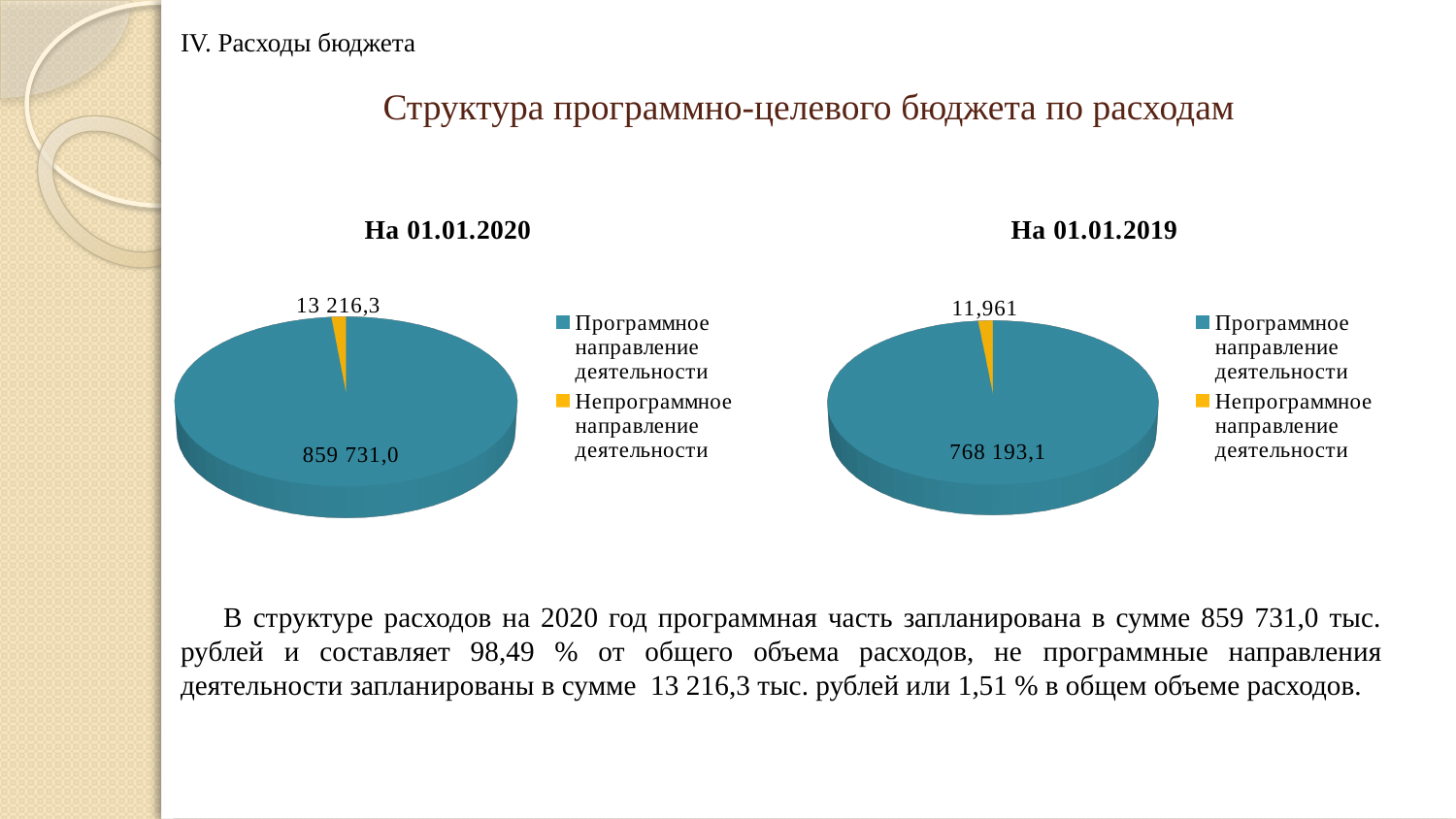
In the pie chart titled 'На 01.01.2020', what is the value for 'Программное направление деятельности'? 859 731,0 In the pie chart titled 'На 01.01.2020', what share of the total does 'Программное направление деятельности' represent? 98,49 % In the pie chart titled 'На 01.01.2019', what value is labelled on the 'Непрограммное направление деятельности' slice? 11,961 In the pie chart titled 'На 01.01.2019', which category has the smallest slice? Непрограммное направление деятельности In the pie chart titled 'На 01.01.2019', what is the value for 'Программное направление деятельности'? 768 193,1 In the pie chart titled 'На 01.01.2020', what is the difference between the 'Программное' and 'Непрограммное' values? 846 514,7 What type of chart is used for 'На 01.01.2020'? Pie chart In the pie chart titled 'На 01.01.2020', which category has the largest slice? Программное направление деятельности Which is larger: the 'Программное направление деятельности' value in the 'На 01.01.2020' chart or in the 'На 01.01.2019' chart? На 01.01.2020 How many slices does the pie chart titled 'На 01.01.2019' have? 2 In the pie chart titled 'На 01.01.2019', what colour is the 'Непрограммное направление деятельности' slice? Yellow In the pie chart titled 'На 01.01.2020', what is the value for 'Непрограммное направление деятельности'? 13 216,3